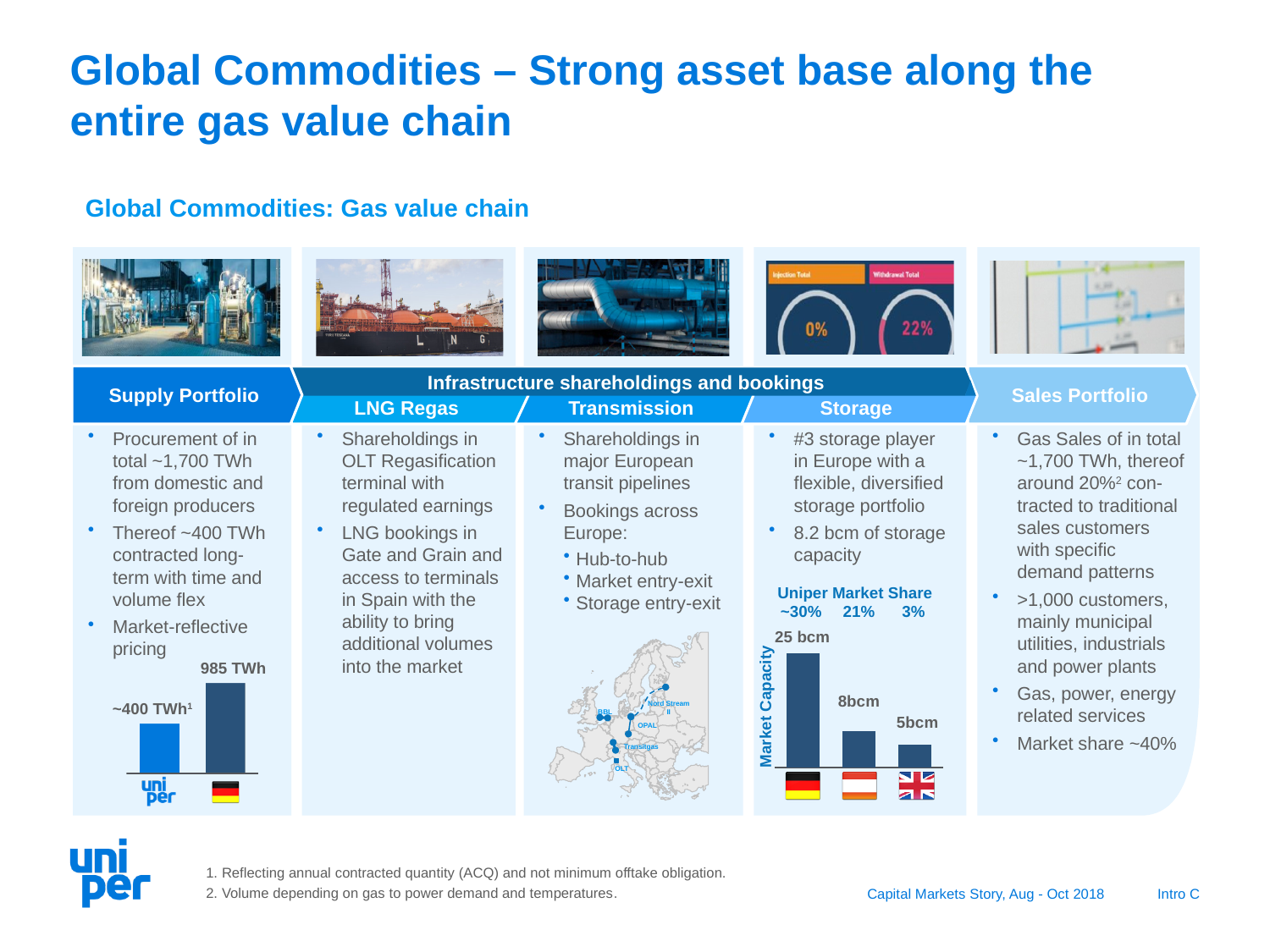
On the Storage chart (Market Capacity), what is the difference between the German and Austrian storage capacities? 17 bcm On the Storage chart (Market Capacity), which country has the highest storage capacity? Germany On the Storage chart (Market Capacity), what is the storage capacity shown for the UK? 5bcm On the Storage chart (Market Capacity), what is the storage capacity shown for Germany? 25 bcm On the Supply Portfolio chart, which bar is larger: the Uniper bar or the Germany bar? Germany On the Storage chart, what is the Uniper Market Share shown for Austria? 21% On the Storage chart (Market Capacity), which country has the lowest storage capacity? UK On the Storage chart (Market Capacity), how many countries are shown as bars? 3 On the Supply Portfolio chart, what value is shown for the bar labelled with the German flag? 985 TWh What type of chart is used in the Storage section to show Market Capacity? Bar chart On the Storage chart (Market Capacity), what is the storage capacity shown for Austria? 8bcm On the Storage chart, what is the difference between the Uniper Market Share for Austria and for the UK? 18%